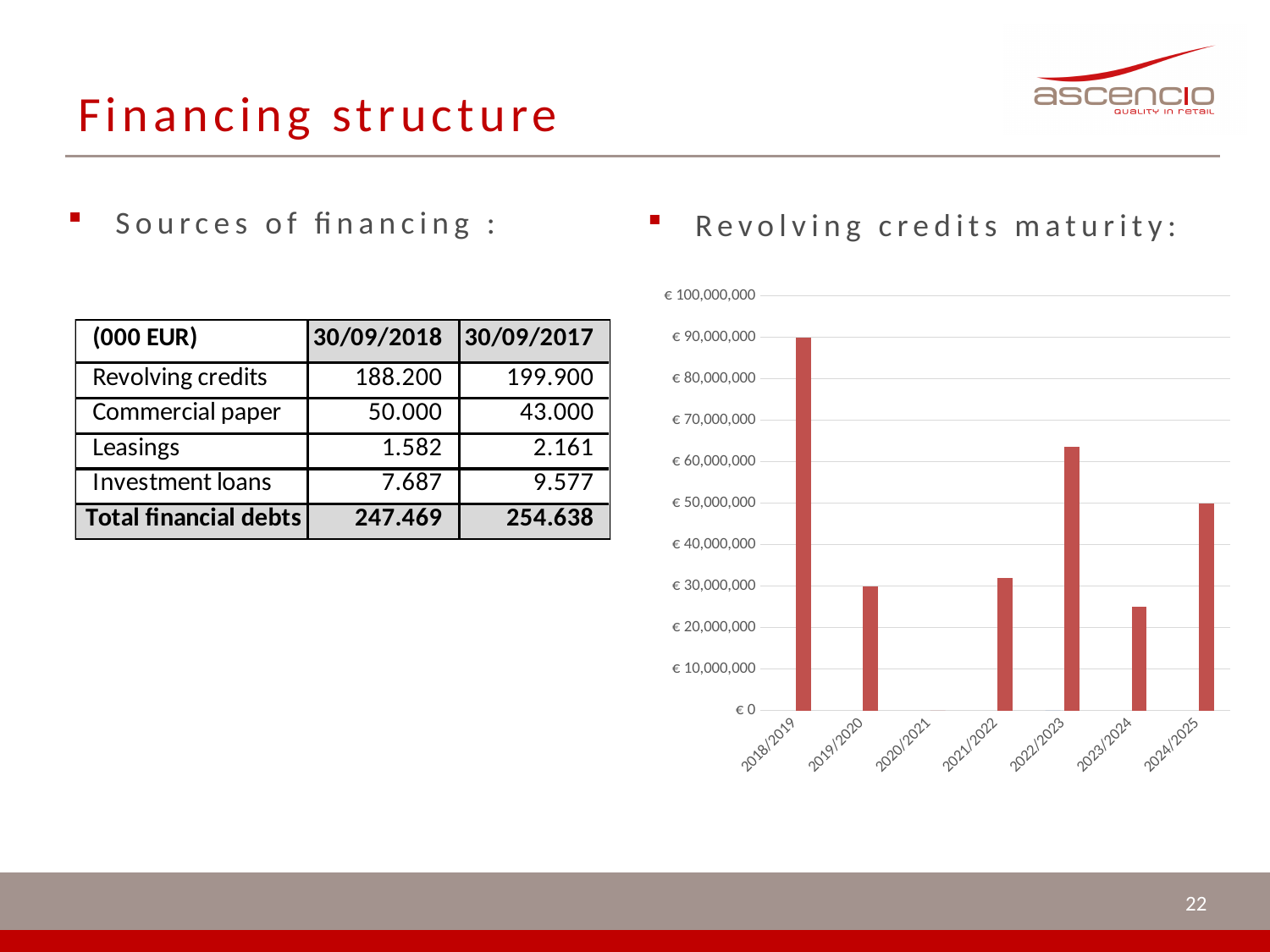
In the revolving credits maturity chart, is the value for 2024/2025 greater or less than € 60,000,000? less In the revolving credits maturity chart, which year has the highest bar? 2018/2019 What is the highest value shown on the y axis of the revolving credits maturity chart? € 100,000,000 In the revolving credits maturity chart, which is larger: the bar for 2022/2023 or the bar for 2024/2025? 2022/2023 In the revolving credits maturity chart, is the value for 2018/2019 greater or less than € 80,000,000? greater How many year categories are shown on the x axis of the revolving credits maturity chart? 7 In the revolving credits maturity chart, is the value for 2022/2023 greater or less than € 60,000,000? greater In the revolving credits maturity chart, which year has the lowest non-zero bar? 2023/2024 What kind of chart is shown under "Revolving credits maturity"? bar chart In the revolving credits maturity chart, which year shows no bar at all? 2020/2021